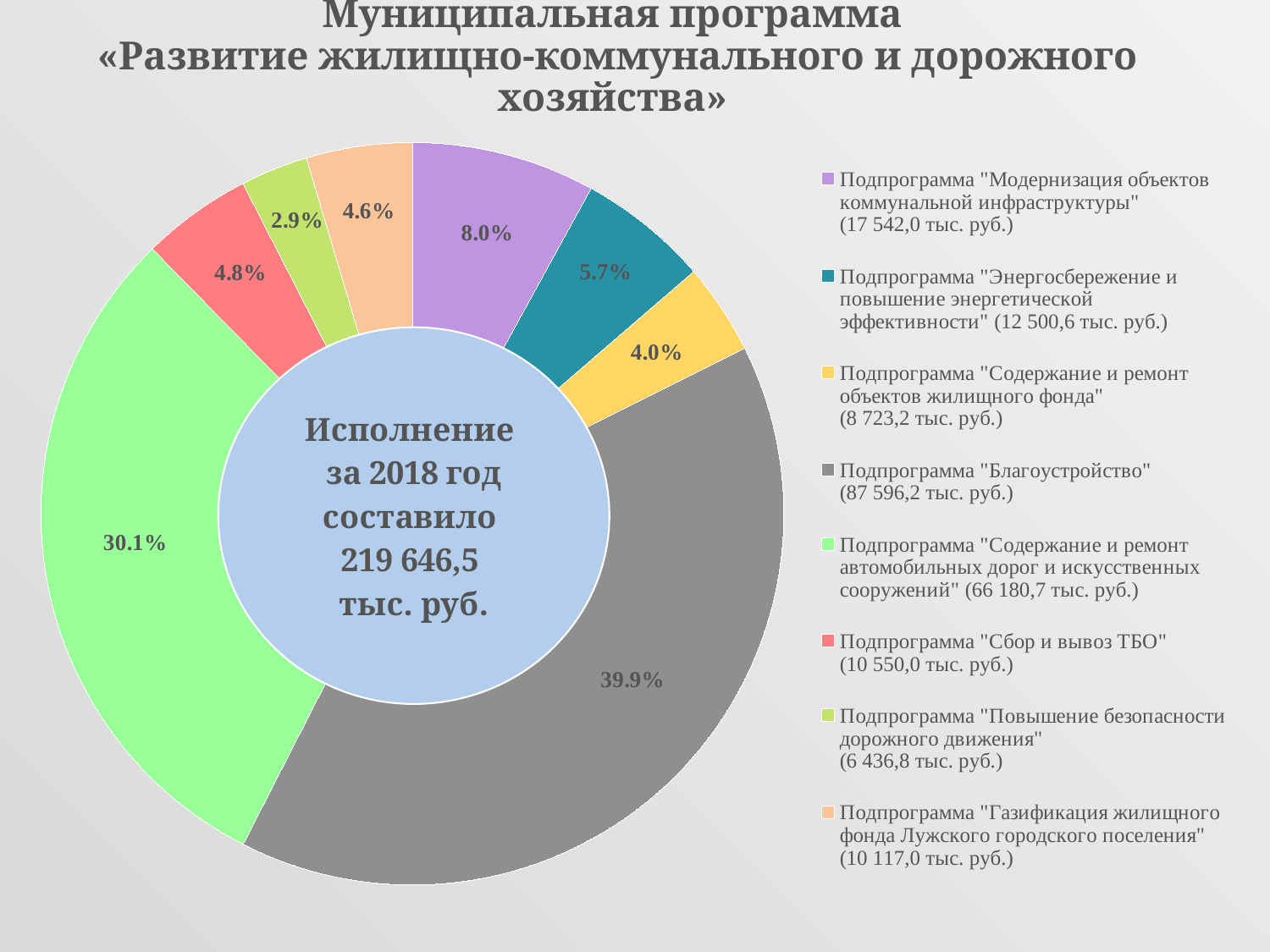
What percentage share is shown for the subprogram "Модернизация объектов коммунальной инфраструктуры"? 8.0% What total execution amount for 2018 is shown in the centre of the chart? 219 646,5 тыс. руб. Which has the larger share: "Энергосбережение и повышение энергетической эффективности" or "Сбор и вывоз ТБО"? Подпрограмма "Энергосбережение и повышение энергетической эффективности" What percentage share is shown for the subprogram "Газификация жилищного фонда Лужского городского поселения"? 4.6% What is the difference in percentage points between the shares of "Благоустройство" and "Содержание и ремонт автомобильных дорог и искусственных сооружений"? 9.8 percentage points According to the legend, what amount in thousand rubles is given for the subprogram "Благоустройство"? 87 596,2 тыс. руб. What kind of chart is shown on the slide? doughnut chart Which subprogram has the largest share of the pie? Подпрограмма "Благоустройство" Which subprogram has the smallest share of the pie? Подпрограмма "Повышение безопасности дорожного движения" What percentage share is shown for the subprogram "Содержание и ремонт автомобильных дорог и искусственных сооружений"? 30.1% What percentage share is shown for the subprogram "Благоустройство"? 39.9% How many slices does the pie chart have? 8